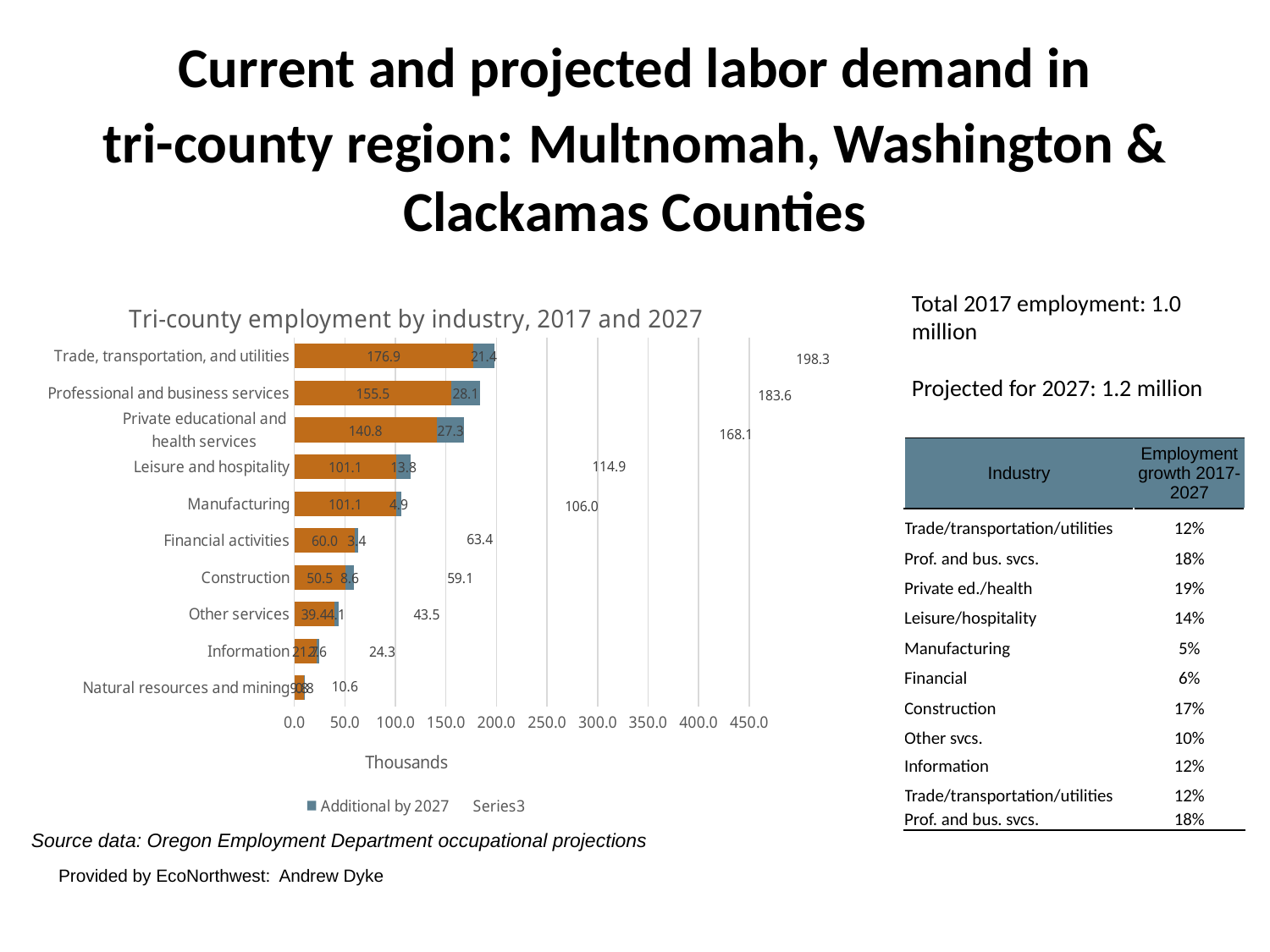
How many industry categories are plotted in the chart? 10 What is the Series3 value for Leisure and hospitality? 114.9 What unit label is shown on the x axis of the chart? Thousands What is the Series3 value for Private educational and health services? 168.1 Which industry has the highest Series3 value? Trade, transportation, and utilities What is the 'Additional by 2027' value for Professional and business services? 28.1 Which industry has the lowest Series3 value? Natural resources and mining What kind of chart is shown on the slide? bar chart Which has the larger 'Additional by 2027' value, Leisure and hospitality or Manufacturing? Leisure and hospitality What is the title of the chart? Tri-county employment by industry, 2017 and 2027 What is the value of the orange segment for Trade, transportation, and utilities? 176.9 What is the difference between the Series3 values for Trade, transportation, and utilities and Professional and business services? 14.7